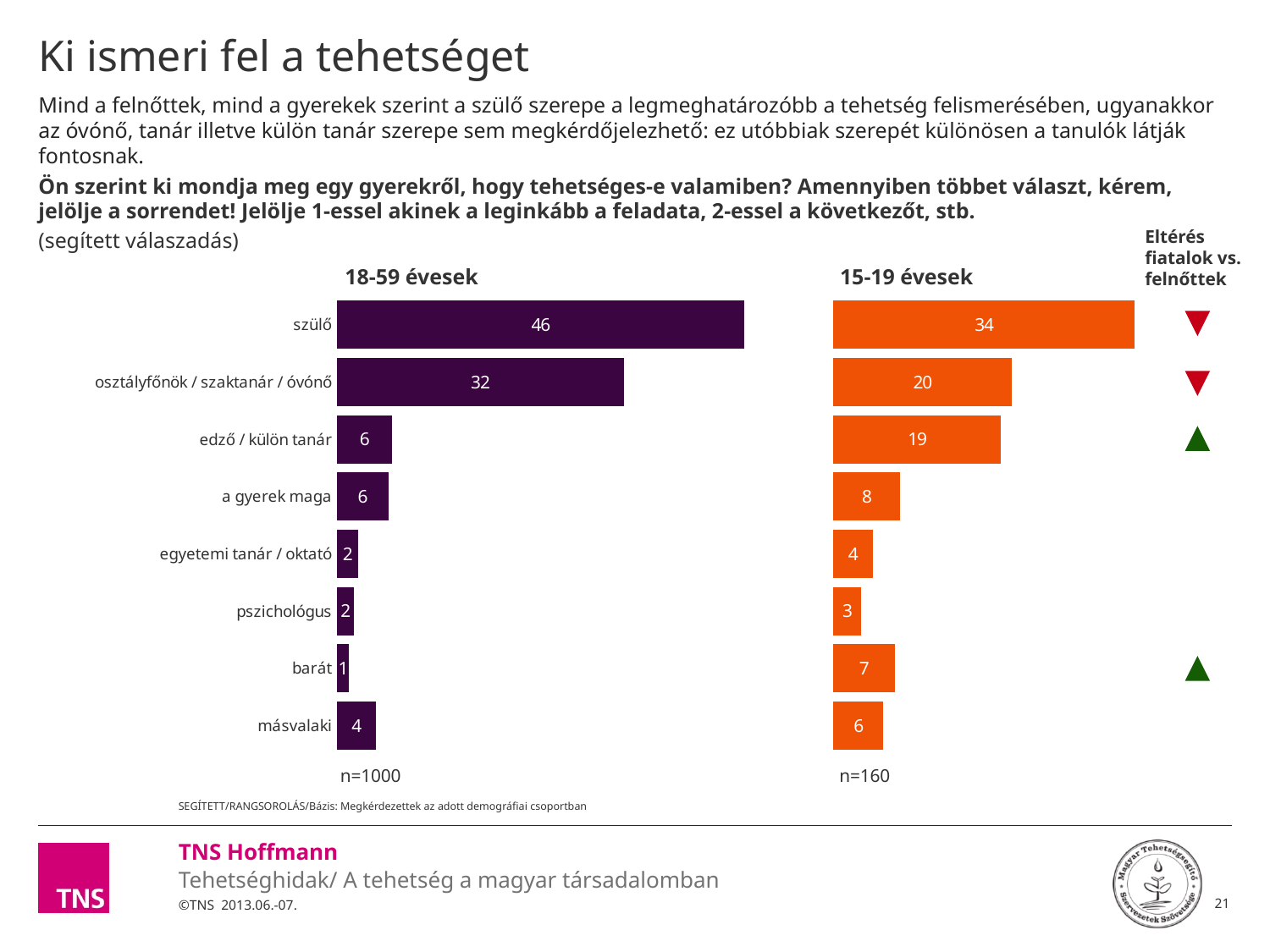
In the "15-19 évesek" chart, what is the value for barát? 7 In the "18-59 évesek" chart, what is the value for szülő? 46 In the "15-19 évesek" chart, which category has the lowest value? pszichológus How many categories are shown in the "18-59 évesek" chart? 8 What type of chart is the "15-19 évesek" chart? bar chart What is the difference between the szülő values in the "18-59 évesek" chart and the "15-19 évesek" chart? 12 In the "18-59 évesek" chart, which category has the lowest value? barát In the "15-19 évesek" chart, what is the difference between osztályfőnök / szaktanár / óvónő and edző / külön tanár? 1 In the "18-59 évesek" chart, which category has the highest value? szülő What is the sample size (n) shown under the "15-19 évesek" chart? n=160 In the "15-19 évesek" chart, what is the value for edző / külön tanár? 19 Which is larger: the value for edző / külön tanár in the "18-59 évesek" chart or in the "15-19 évesek" chart? 15-19 évesek